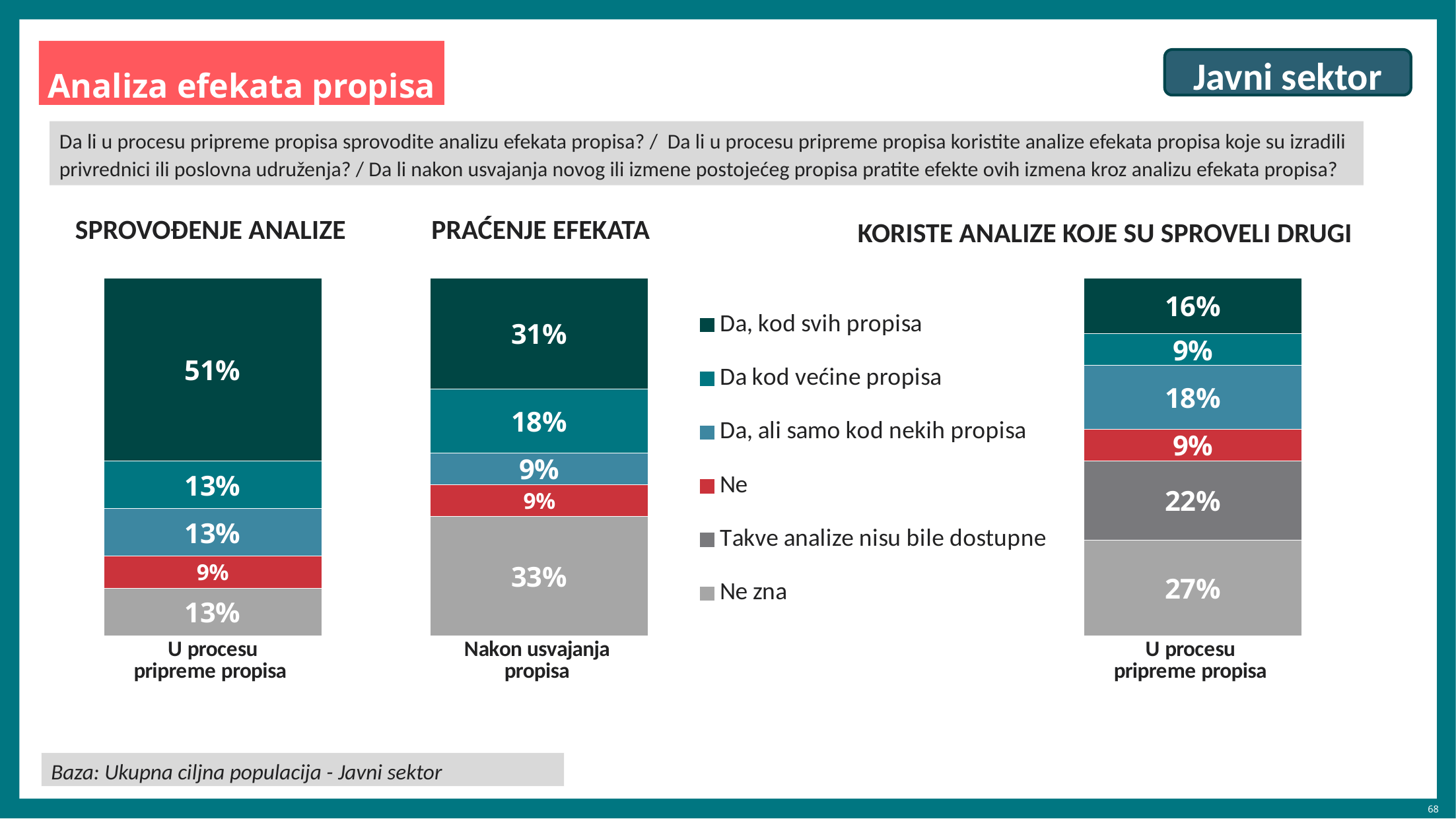
In the SPROVOĐENJE ANALIZE chart, which segment has the lowest value? Ne In the KORISTE ANALIZE KOJE SU SPROVELI DRUGI chart, what is the value for "Da, kod svih propisa"? 16% In the SPROVOĐENJE ANALIZE chart, what is the value for "Da, kod svih propisa"? 51% Which is larger: "Da, kod svih propisa" in the SPROVOĐENJE ANALIZE chart or "Da, kod svih propisa" in the PRAĆENJE EFEKATA chart? SPROVOĐENJE ANALIZE What kind of chart is the PRAĆENJE EFEKATA chart? Stacked bar chart In the PRAĆENJE EFEKATA chart, what is the value for "Ne zna"? 33% In the PRAĆENJE EFEKATA chart, which segment has the highest value? Ne zna In the KORISTE ANALIZE KOJE SU SPROVELI DRUGI chart, what is the value for "Takve analize nisu bile dostupne"? 22% In the KORISTE ANALIZE KOJE SU SPROVELI DRUGI chart, which segment has the highest value? Ne zna How many segments does the bar in the KORISTE ANALIZE KOJE SU SPROVELI DRUGI chart have? 6 In the PRAĆENJE EFEKATA chart, what is the difference between "Da, kod svih propisa" and "Da kod većine propisa"? 13% How many entries does the legend list? 6